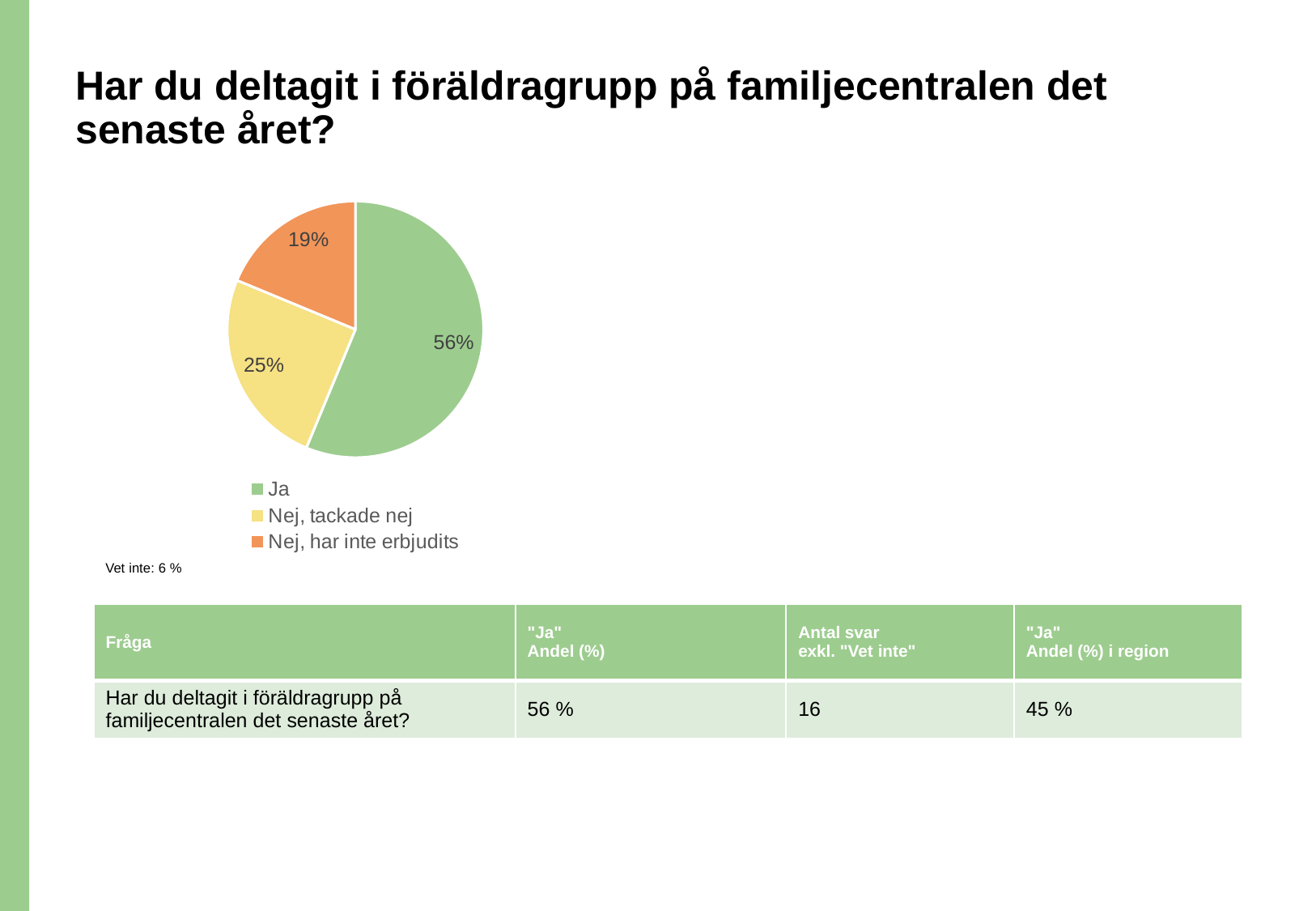
Which category has the smallest slice of the pie? Nej, har inte erbjudits What is the difference in percentage points between "Nej, tackade nej" and "Nej, har inte erbjudits"? 6 How many categories does the pie chart have? 3 What colour is the slice for "Nej, har inte erbjudits"? orange What type of chart is shown on the slide? pie chart What is the difference in percentage points between "Ja" and "Nej, tackade nej"? 31 What share of the pie does "Nej, tackade nej" represent? 25% What share of the pie does "Ja" represent? 56% What share of the pie does "Nej, har inte erbjudits" represent? 19% Which is larger, the slice for "Nej, tackade nej" or the slice for "Nej, har inte erbjudits"? Nej, tackade nej Which category has the largest slice of the pie? Ja What colour is the slice for "Ja"? green